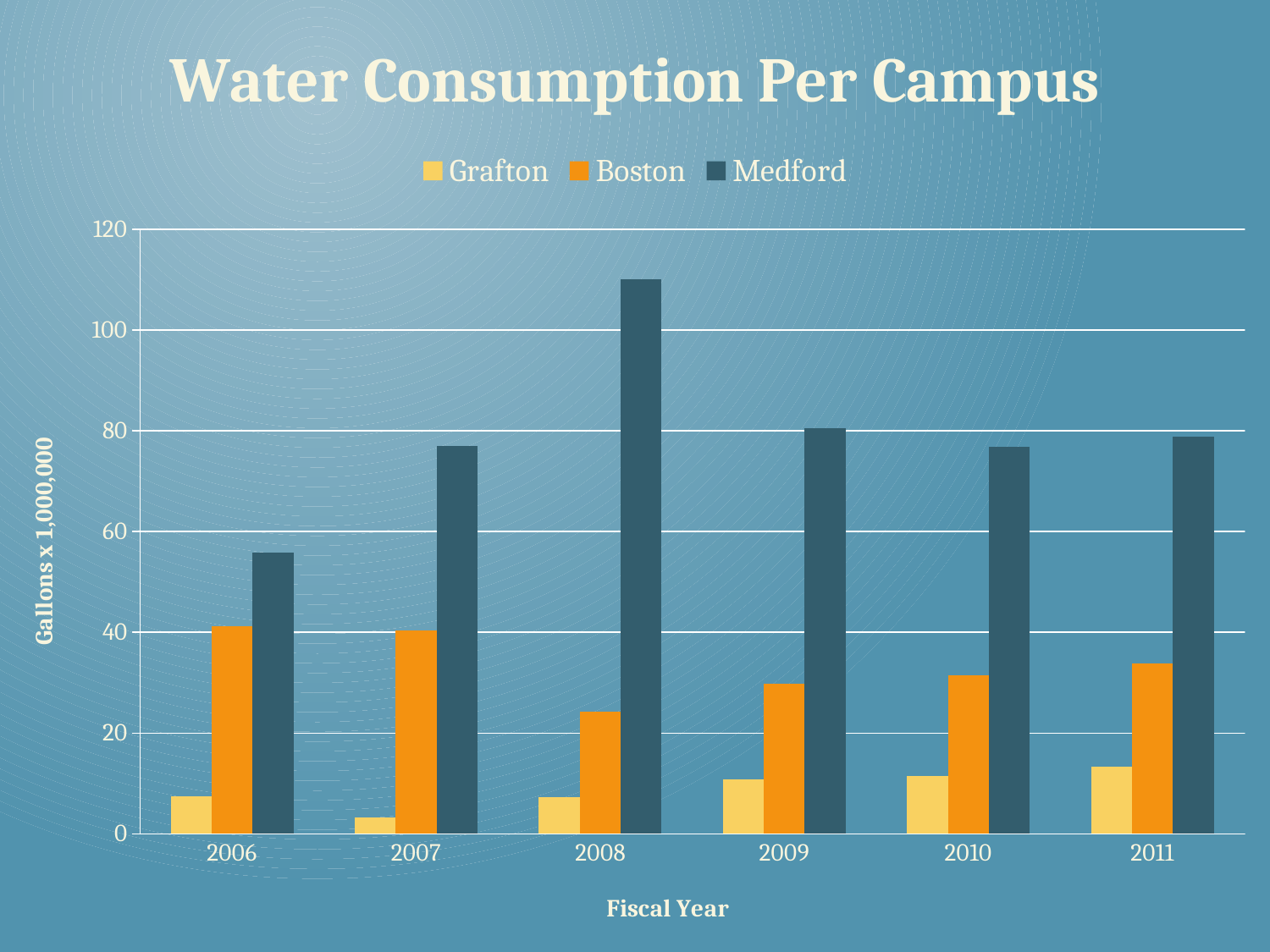
Is the value for Medford in 2006 greater or less than 60? less Is the value for Medford in 2008 greater or less than 100? greater In which fiscal year is the Medford bar highest? 2008 What kind of chart is shown on the slide? bar chart Which campus has the highest water consumption in 2006? Medford Is the value for Boston in 2008 greater or less than 30? less In which fiscal year is the Grafton bar lowest? 2007 How many series does the legend list? 3 Which is larger, the Boston value in 2006 or the Boston value in 2008? 2006 In which fiscal year is the Boston bar lowest? 2008 What is the label on the vertical axis? Gallons x 1,000,000 How many fiscal years are shown on the x axis? 6